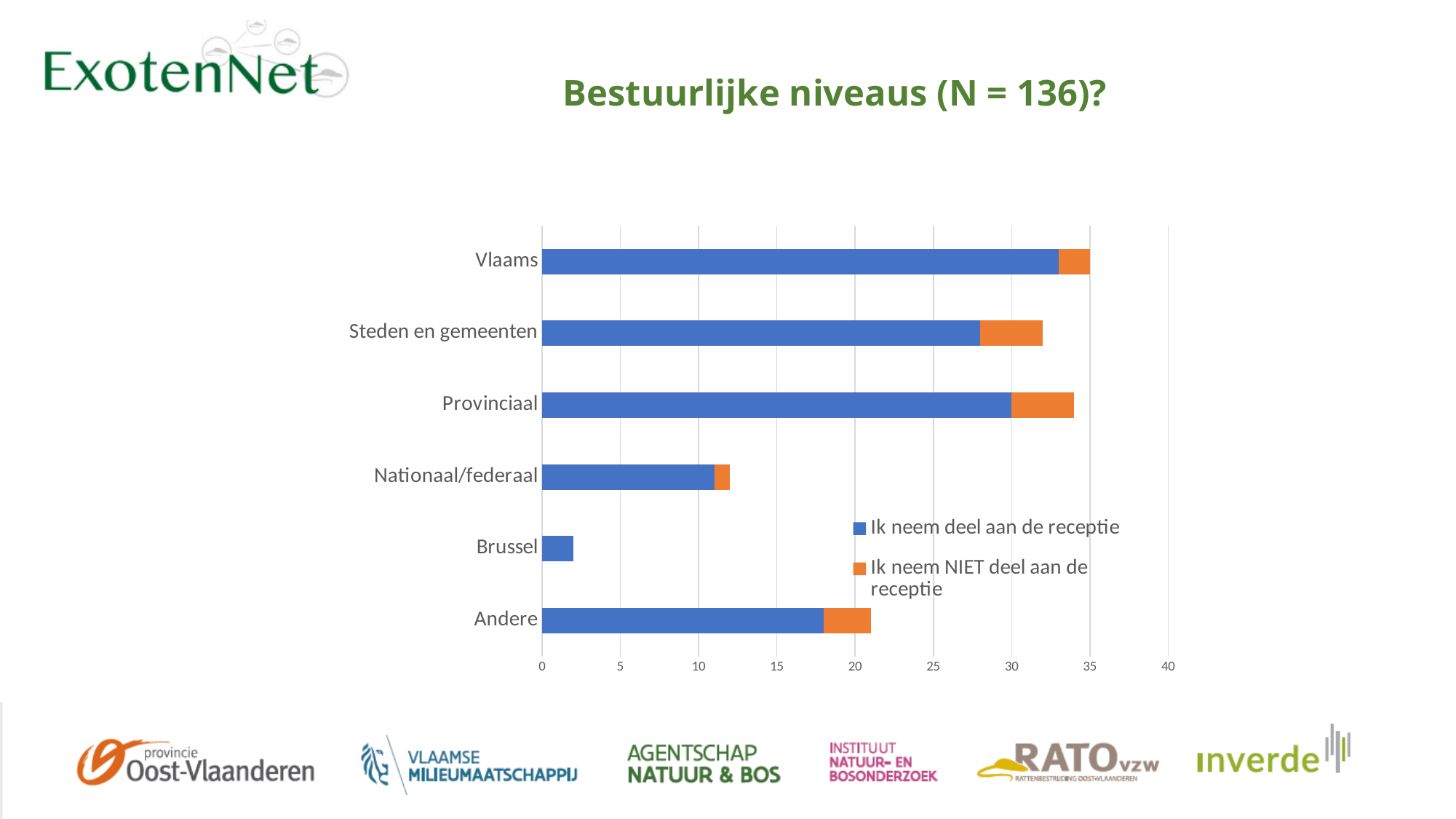
What is the title of the chart? Bestuurlijke niveaus (N = 136)? Is the total value for Steden en gemeenten greater or less than 30? greater What kind of chart is shown on the slide? bar chart Which has a larger total value, Brussel or Andere? Andere How many series does the legend list? 2 Is the value for Brussel greater or less than 5? less Which has a larger total value, Steden en gemeenten or Nationaal/federaal? Steden en gemeenten Is the total value for Vlaams greater or less than 30? greater Which category has the lowest total value? Brussel How many categories (bestuurlijke niveaus) are shown on the chart? 6